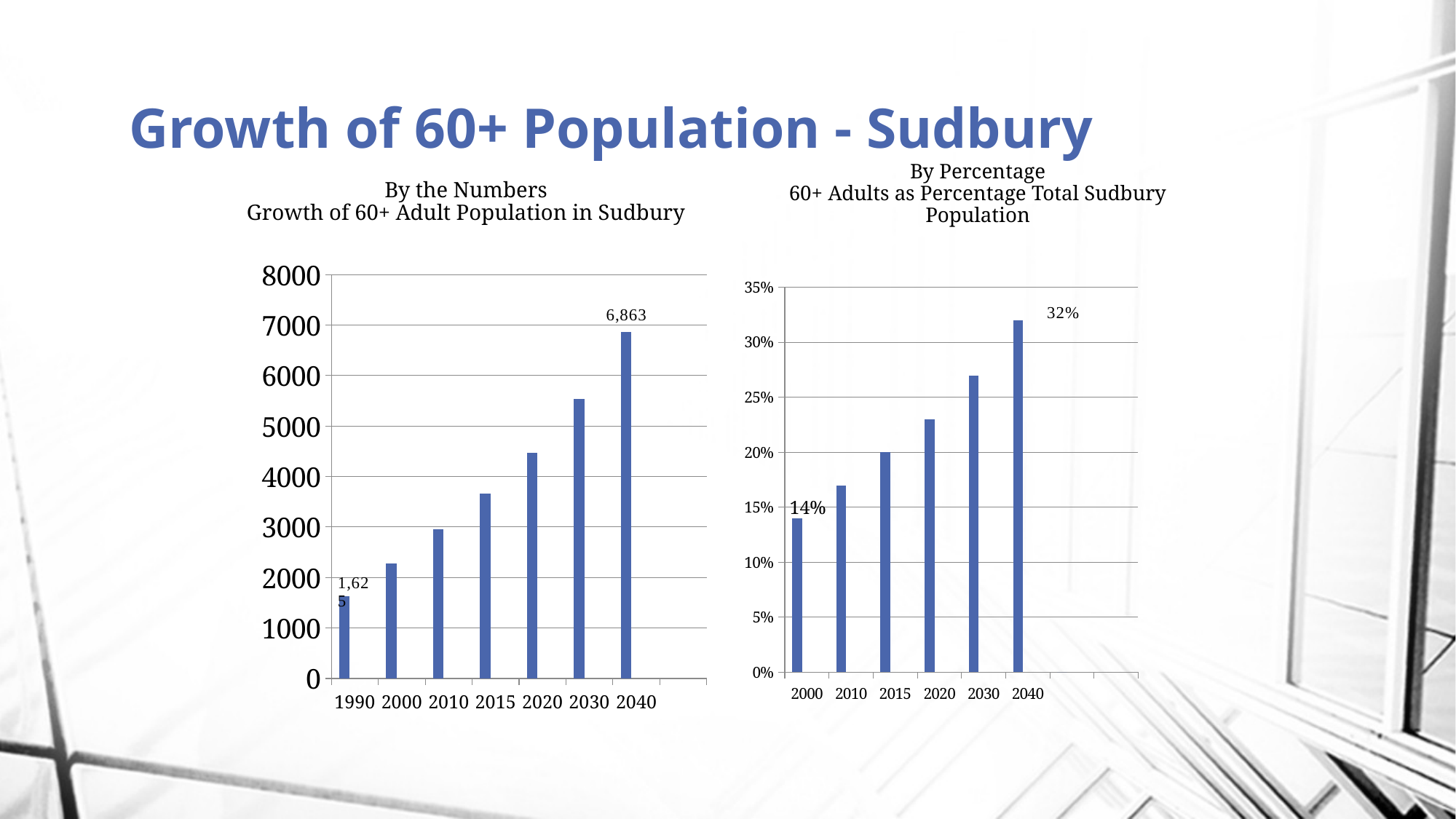
In the 'By Percentage' chart, what is the value for 2000? 14% In the 'By the Numbers' chart, is the value for 2020 greater or less than 4000? greater In the 'By the Numbers' chart, what is the value for 1990? 1,625 In the 'By the Numbers' chart, how many years are shown on the x axis? 7 In the 'By the Numbers' chart, which year has the lowest value? 1990 In the 'By Percentage' chart, what is the value for 2040? 32% In the 'By Percentage' chart, is the value for 2030 greater or less than 25%? greater In the 'By the Numbers' chart, what is the value for 2040? 6,863 In the 'By Percentage' chart, what is the difference between the 2040 value and the 2000 value? 18% In the 'By Percentage' chart, do the values rise or fall from 2000 to 2040? rise In the 'By the Numbers' chart, what is the difference between the 2040 value and the 1990 value? 5,238 In the 'By the Numbers' chart, which year has the highest value? 2040